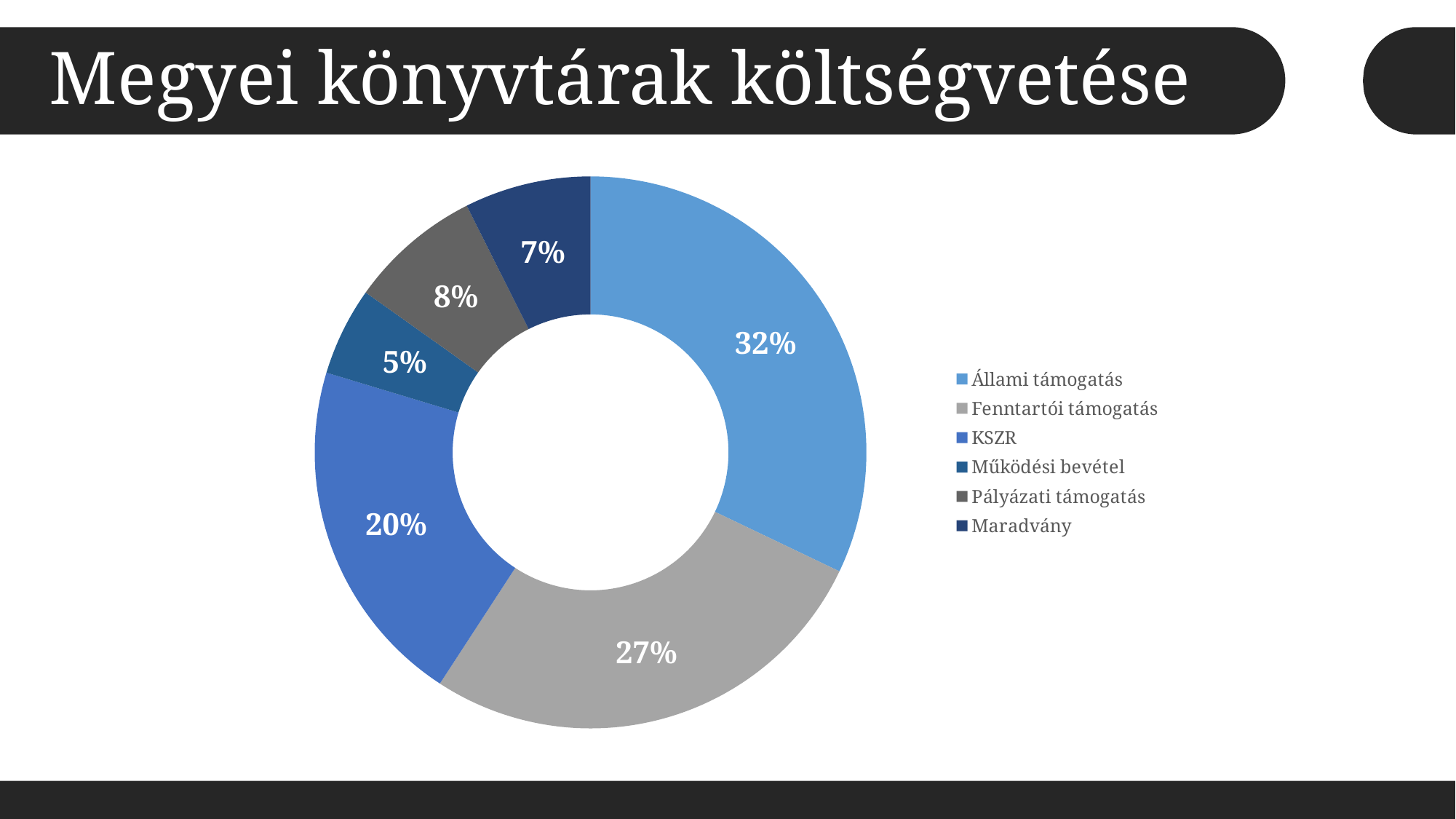
What share of the budget is Állami támogatás? 32% How many categories does the chart show? 6 What share of the budget is Pályázati támogatás? 8% What share of the budget is KSZR? 20% What share of the budget is Működési bevétel? 5% Which is larger, Pályázati támogatás or Maradvány? Pályázati támogatás Which category has the largest share? Állami támogatás Which category has the smallest share? Működési bevétel What share of the budget is Maradvány? 7% What share of the budget is Fenntartói támogatás? 27% What is the difference in percentage points between Állami támogatás and Fenntartói támogatás? 5 What kind of chart is shown on the slide? Doughnut (pie) chart